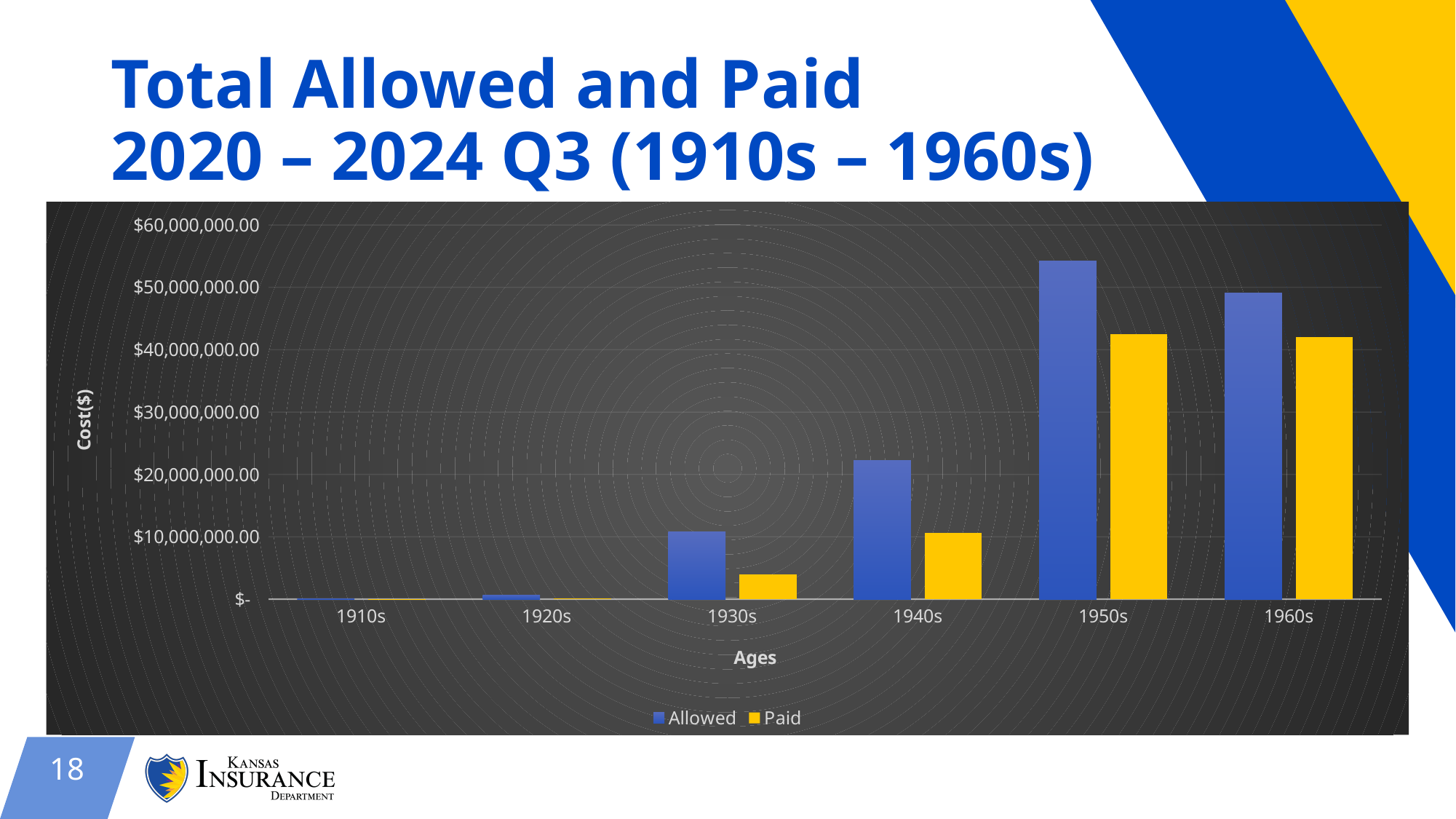
Is the Paid value for the 1930s greater or less than $10,000,000.00? less How many age-decade categories are shown on the x axis? 6 Which decade has the lowest Allowed value? 1910s Which decade has the larger Allowed value, the 1930s or the 1940s? 1940s Is the Allowed value for the 1950s greater or less than $50,000,000.00? greater Is the Allowed value for the 1940s greater or less than $20,000,000.00? greater How many series does the legend list? 2 What kind of chart is shown on the slide? Bar chart What is the title of the vertical axis? Cost($) Which is larger for the 1950s, the Allowed value or the Paid value? Allowed Which decade has the highest Allowed value? 1950s